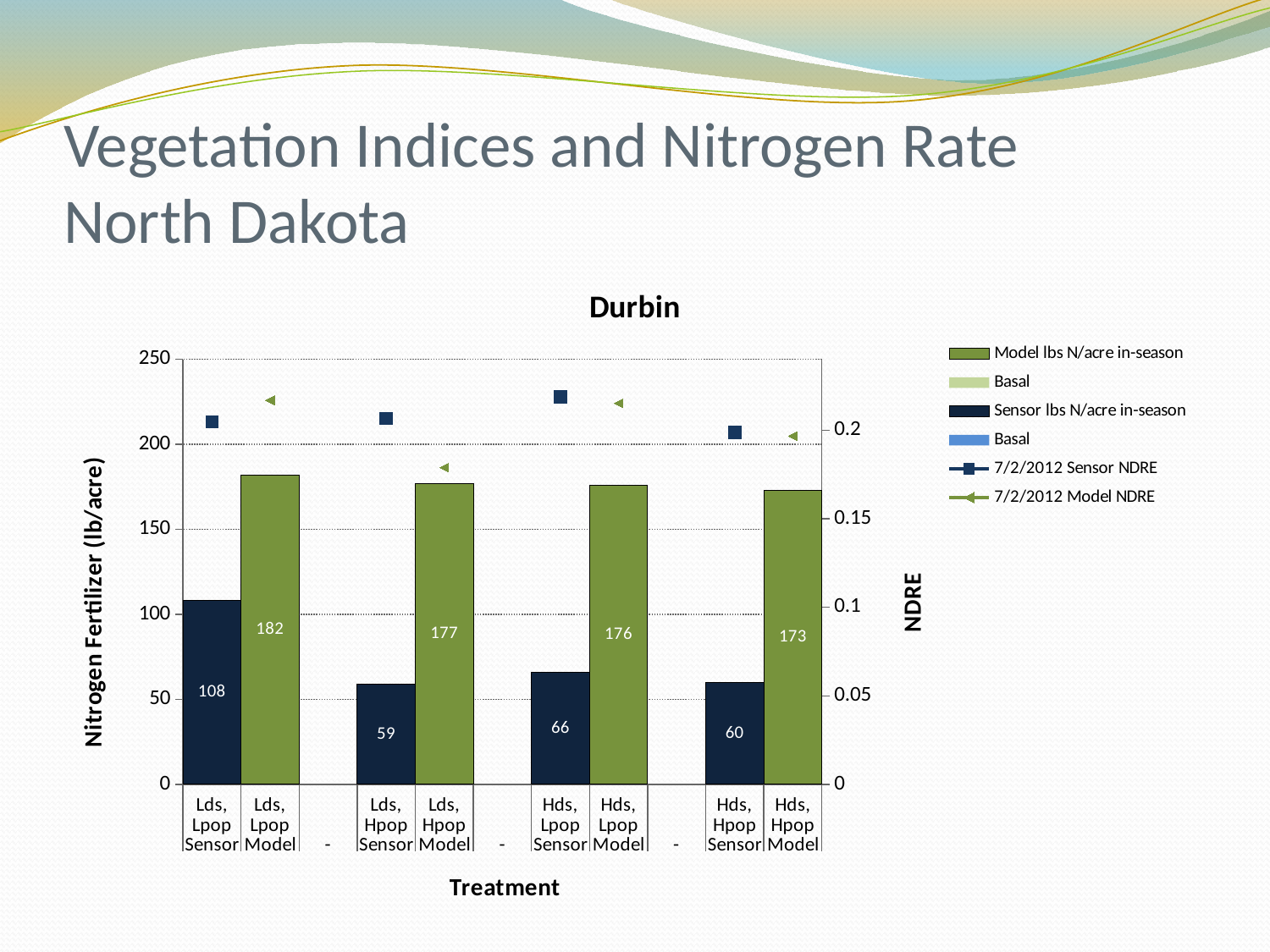
Which is larger, the Sensor lbs N/acre in-season value for Hds, Lpop or for Hds, Hpop? Hds, Lpop What kind of chart is shown on the slide? combination bar and line chart What is the Sensor lbs N/acre in-season value for the Lds, Hpop treatment? 59 How many entries does the legend list? 6 What is the Sensor lbs N/acre in-season value for the Lds, Lpop treatment? 108 What is the difference between the Model and Sensor lbs N/acre in-season values for the Hds, Lpop treatment? 110 What is the label of the left vertical axis? Nitrogen Fertilizer (lb/acre) What is the chart title? Durbin What is the Model lbs N/acre in-season value for the Hds, Hpop treatment? 173 Which treatment has the highest Model lbs N/acre in-season value? Lds, Lpop Is the 7/2/2012 Sensor NDRE value for the Lds, Lpop treatment greater or less than 0.15? greater Which treatment has the lowest Sensor lbs N/acre in-season value? Lds, Hpop